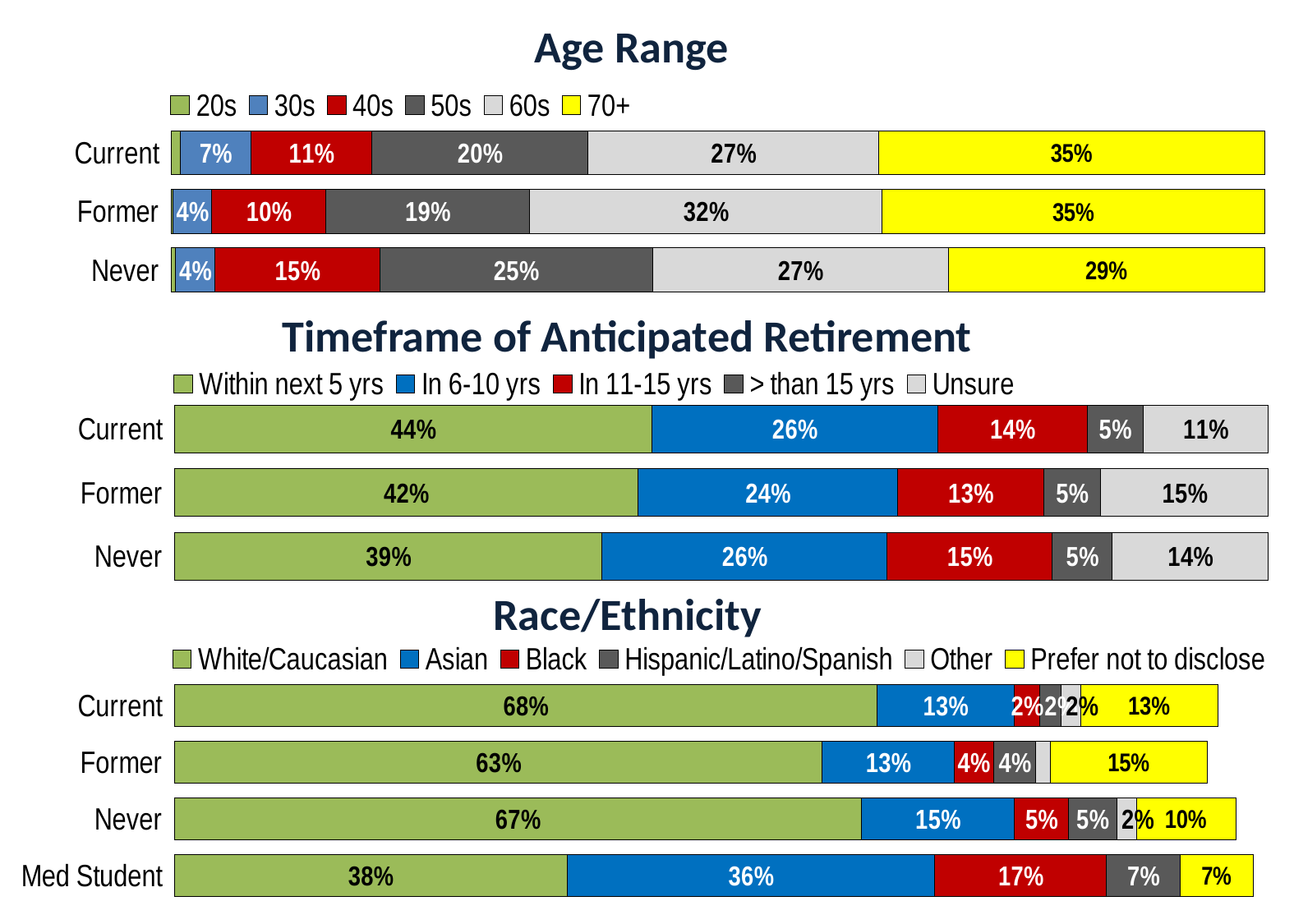
In the Age Range chart, which group has a larger share in their 60s, Former or Never? Former How many series does the legend of the Timeframe of Anticipated Retirement chart list? 5 How many groups (bars) are shown in the Race/Ethnicity chart? 4 In the Age Range chart, what percentage of the Never group is in their 50s? 25% In the Timeframe of Anticipated Retirement chart, what is the difference in percentage points between the Current and Never groups for 'Within next 5 yrs'? 5 percentage points In the Race/Ethnicity chart, what percentage of Med Students are Asian? 36% What kind of chart is the Race/Ethnicity chart? Stacked bar chart In the Age Range chart, which group has the largest share in the 40s age range? Never In the Age Range chart, what percentage of the Former group is in their 60s? 32% In the Timeframe of Anticipated Retirement chart, what percentage of the Current group anticipates retiring within the next 5 years? 44% In the Timeframe of Anticipated Retirement chart, what percentage of the Former group is Unsure? 15% In the Age Range chart, what percentage of the Current group is in the 70+ age range? 35%